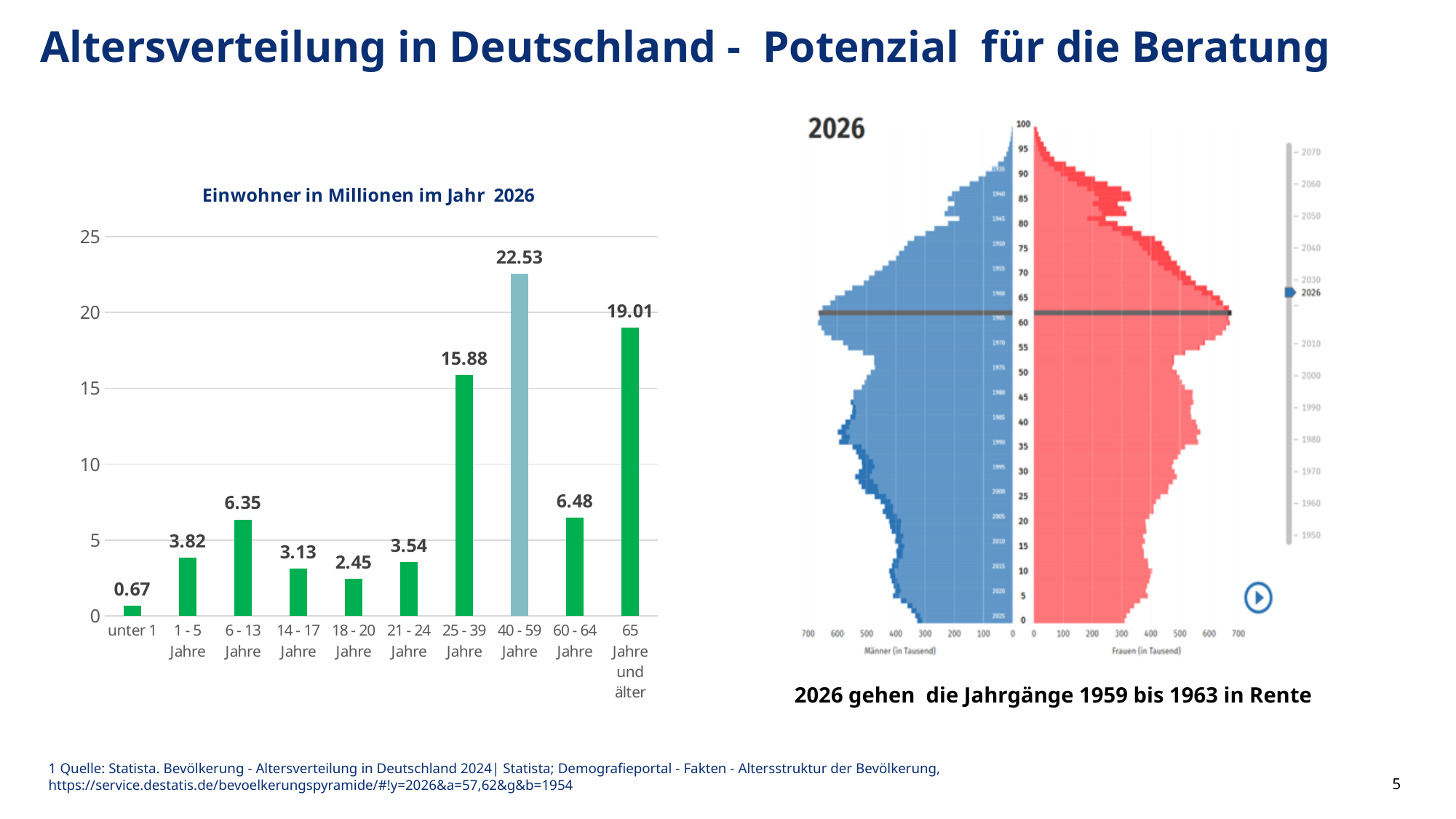
In the chart 'Einwohner in Millionen im Jahr 2026', what is the value for the 40 - 59 Jahre group? 22.53 In the chart 'Einwohner in Millionen im Jahr 2026', what is the value for the 18 - 20 Jahre group? 2.45 In the chart 'Einwohner in Millionen im Jahr 2026', which age group has the highest value? 40 - 59 Jahre In the chart 'Einwohner in Millionen im Jahr 2026', is the value for 25 - 39 Jahre greater or less than 15? greater How many age groups are shown in the chart 'Einwohner in Millionen im Jahr 2026'? 10 In the chart 'Einwohner in Millionen im Jahr 2026', which is larger: the value for 60 - 64 Jahre or the value for 6 - 13 Jahre? 60 - 64 Jahre In the chart 'Einwohner in Millionen im Jahr 2026', what is the value for the 65 Jahre und älter group? 19.01 In the chart 'Einwohner in Millionen im Jahr 2026', which bar is shown in a different colour from the others? 40 - 59 Jahre In the chart 'Einwohner in Millionen im Jahr 2026', which age group has the lowest value? unter 1 What year is shown in the population pyramid on the right side of the slide? 2026 In the chart 'Einwohner in Millionen im Jahr 2026', what is the difference between the 40 - 59 Jahre group and the 65 Jahre und älter group? 3.52 What kind of chart is 'Einwohner in Millionen im Jahr 2026'? bar chart